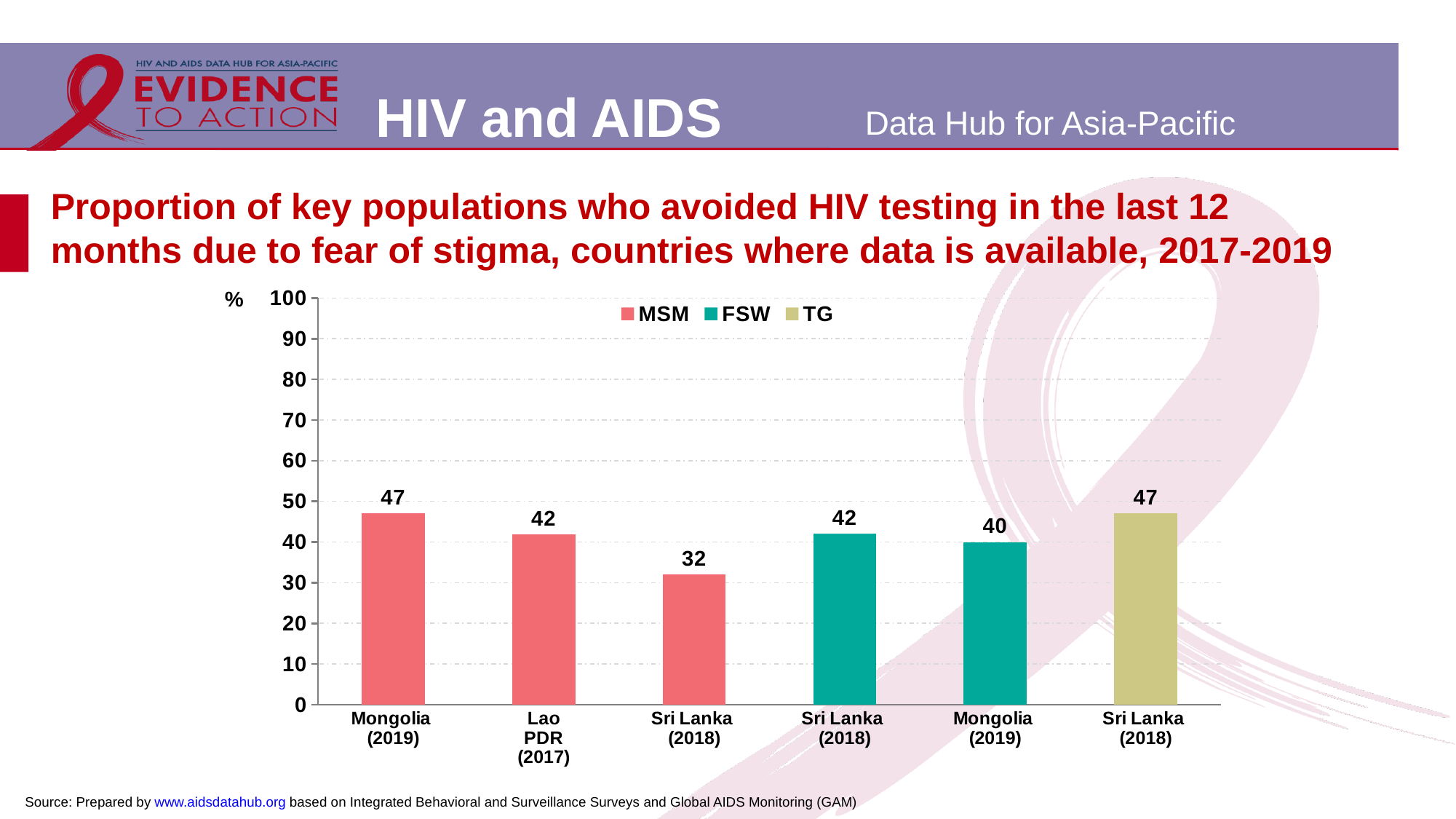
What is the value for MSM in Lao PDR (2017)? 42 What is the value for MSM in Mongolia (2019)? 47 What kind of chart is shown on the slide? bar chart How many series does the legend list? 3 Is the value for MSM in Lao PDR (2017) greater or less than 50? less Which bar has the lowest value on the chart? Sri Lanka (2018) MSM Which is larger: the MSM value for Sri Lanka (2018) or the FSW value for Sri Lanka (2018)? FSW What is the value for FSW in Mongolia (2019)? 40 What is the difference between the FSW value for Sri Lanka (2018) and the FSW value for Mongolia (2019)? 2 How many bars are plotted on the chart? 6 What is the value for TG in Sri Lanka (2018)? 47 What is the difference between the MSM value for Mongolia (2019) and the MSM value for Sri Lanka (2018)? 15